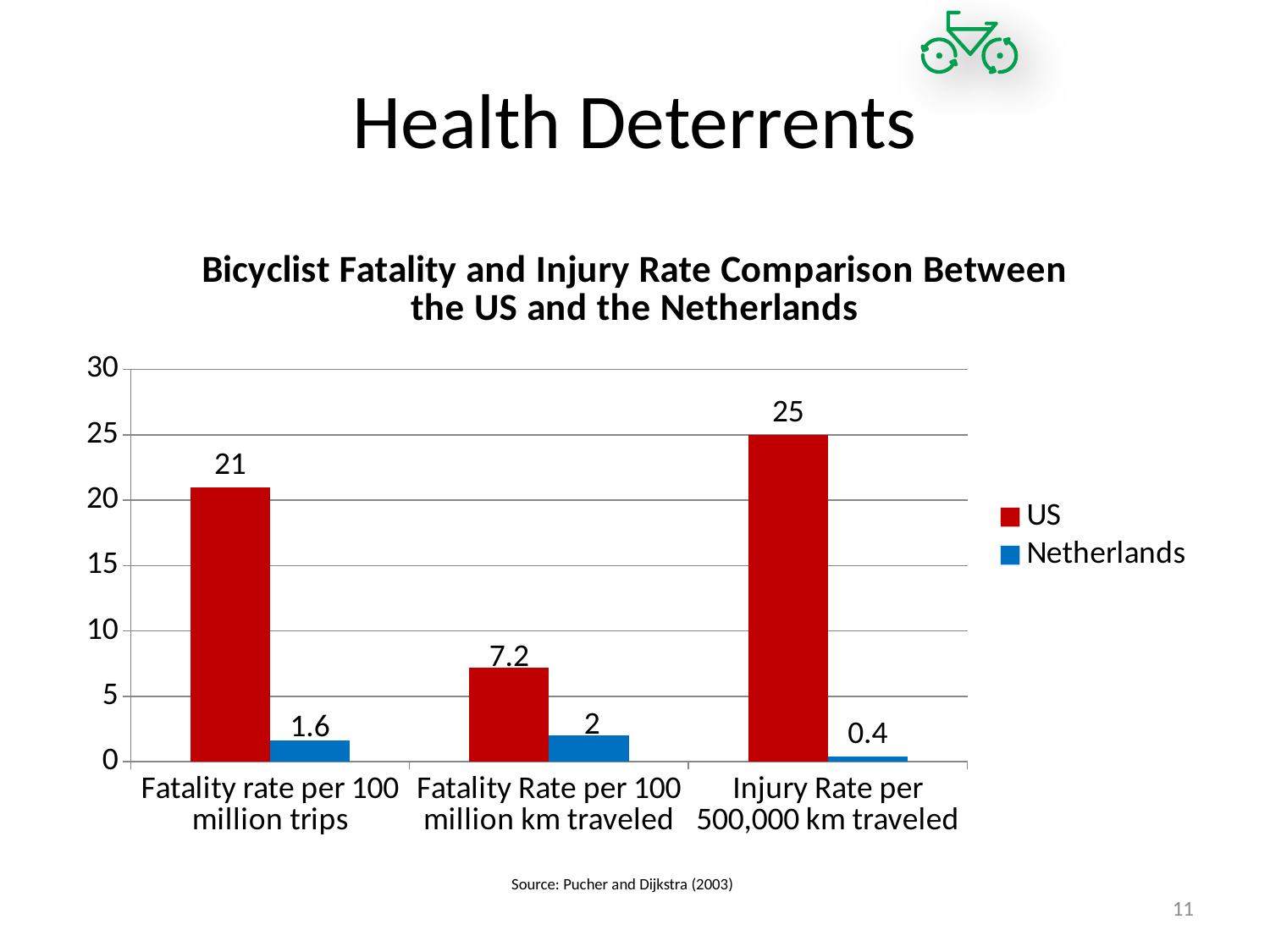
Which is larger for Injury Rate per 500,000 km traveled, the US value or the Netherlands value? US What is the US value for Fatality rate per 100 million trips? 21 How many categories are shown on the x axis? 3 What is the title of the chart? Bicyclist Fatality and Injury Rate Comparison Between the US and the Netherlands How many series does the legend list? 2 Which category has the highest US value? Injury Rate per 500,000 km traveled What is the US value for Fatality Rate per 100 million km traveled? 7.2 What is the difference between the US and Netherlands values for Fatality rate per 100 million trips? 19.4 What is the Netherlands value for Injury Rate per 500,000 km traveled? 0.4 What kind of chart is shown on the slide? Bar chart What is the Netherlands value for Fatality Rate per 100 million km traveled? 2 Which category has the lowest Netherlands value? Injury Rate per 500,000 km traveled